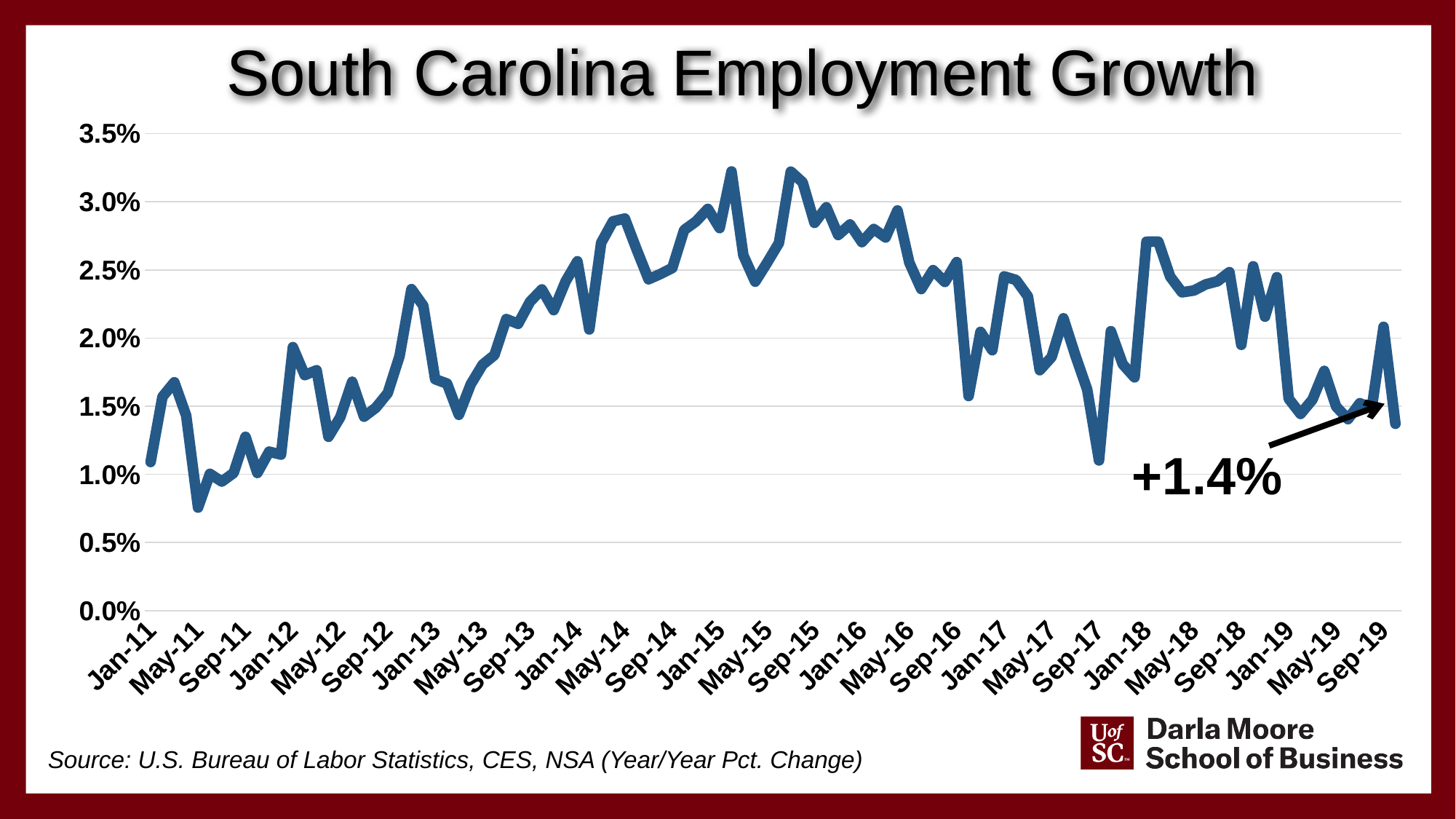
What kind of chart is shown on the slide? Line chart How many lines (series) are plotted on the chart? 1 Is the value for Sep-15 greater or less than 3.0%? less What is the title of the chart? South Carolina Employment Growth Is the value for Jan-15 greater or less than 2.5%? greater What is the highest value shown on the vertical axis? 3.5% Is the value for Jan-11 greater or less than 1.5%? less Does the line rise or fall overall between Jan-11 and Jan-15? Rise What value is annotated at the most recent point on the line? +1.4% Which is larger, the value for Jan-15 or the value for Jan-11? Jan-15 Does the line rise or fall overall between Sep-15 and Sep-17? Fall